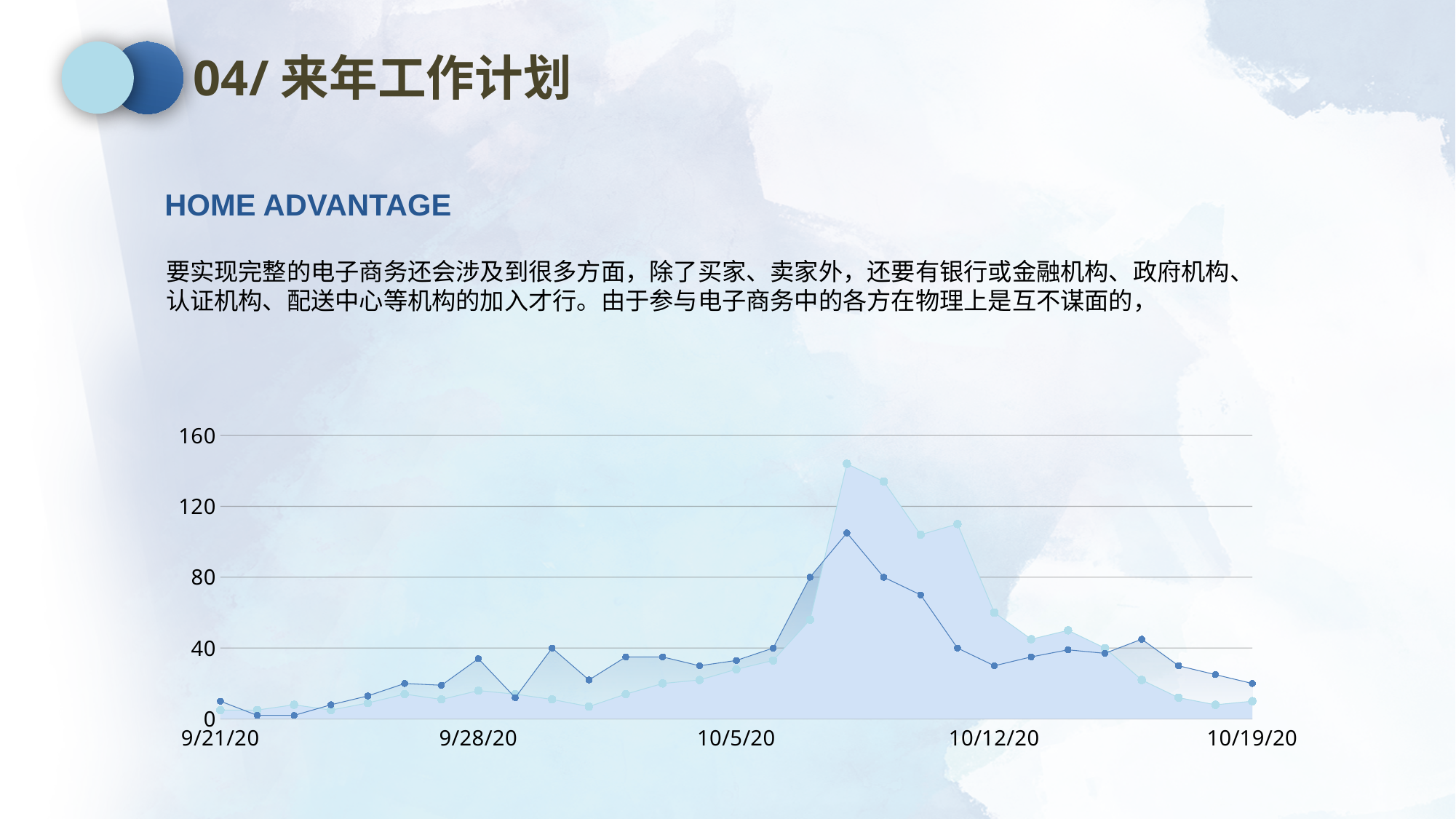
How many date labels are shown on the x axis of the chart? 5 Is the value of the light blue series at 10/12/20 greater or less than 80? less Is the value of the dark blue series at 9/21/20 greater or less than 40? less Is the highest value reached by the light blue series greater or less than 120? greater How many data series are plotted on the chart? 2 What is the first date label on the x axis of the chart? 9/21/20 What kind of chart is shown on the slide? area and line chart What is the highest value shown on the y axis of the chart? 160 Does the dark blue series rise or fall between 10/12/20 and 10/19/20? fall